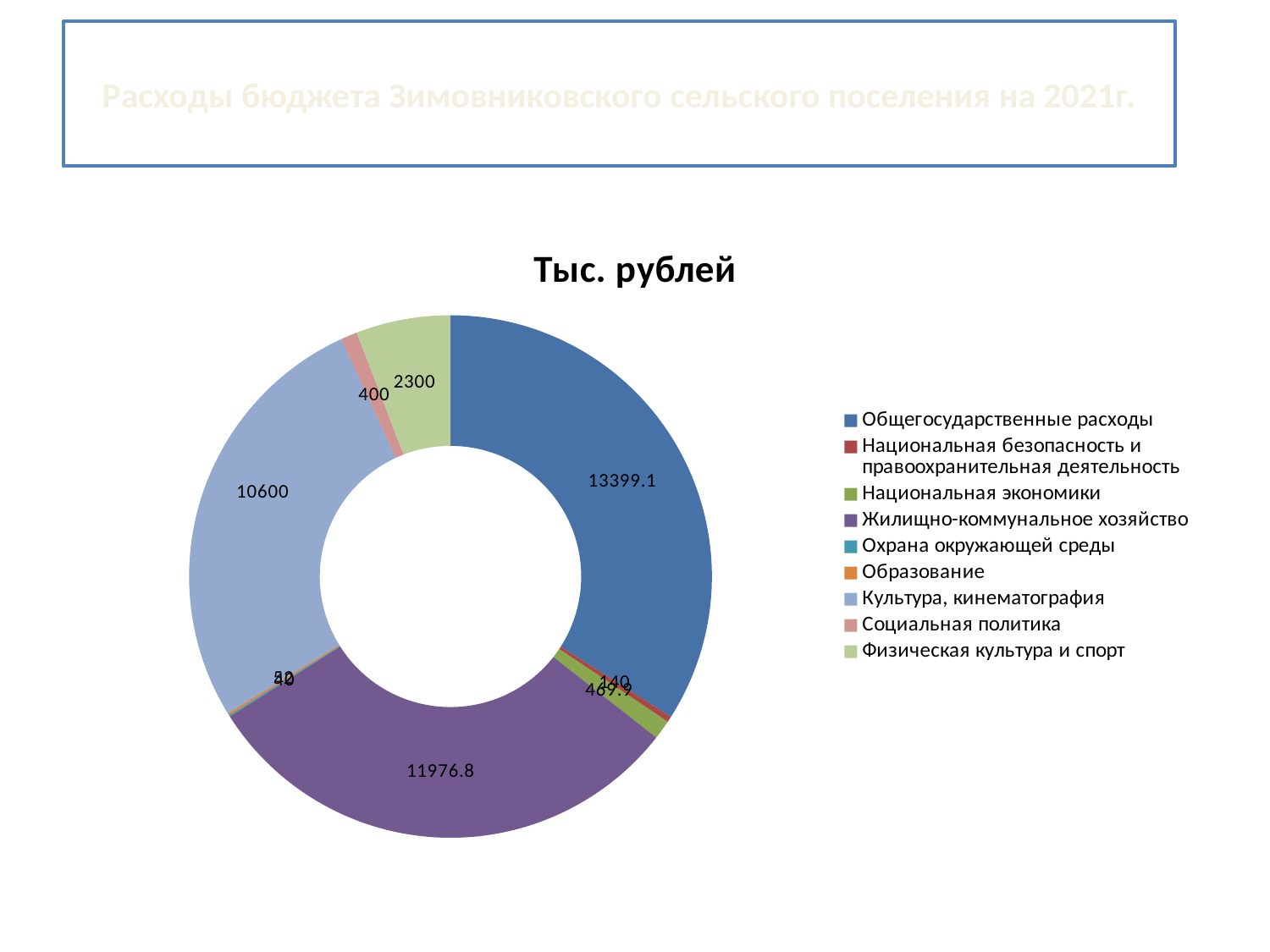
Which is larger: Жилищно-коммунальное хозяйство or Культура, кинематография? Жилищно-коммунальное хозяйство What is the value for Национальная безопасность и правоохранительная деятельность? 140 What is the value for Культура, кинематография? 10600 What is the value for Физическая культура и спорт? 2300 What is the value for Общегосударственные расходы? 13399.1 What kind of chart is shown on the slide? doughnut (pie) chart What is the chart's title? Тыс. рублей What is the difference between Общегосударственные расходы and Жилищно-коммунальное хозяйство? 1422.3 How many categories does the legend list? 9 What is the value for Жилищно-коммунальное хозяйство? 11976.8 What is the value for Социальная политика? 400 Which category has the largest value? Общегосударственные расходы